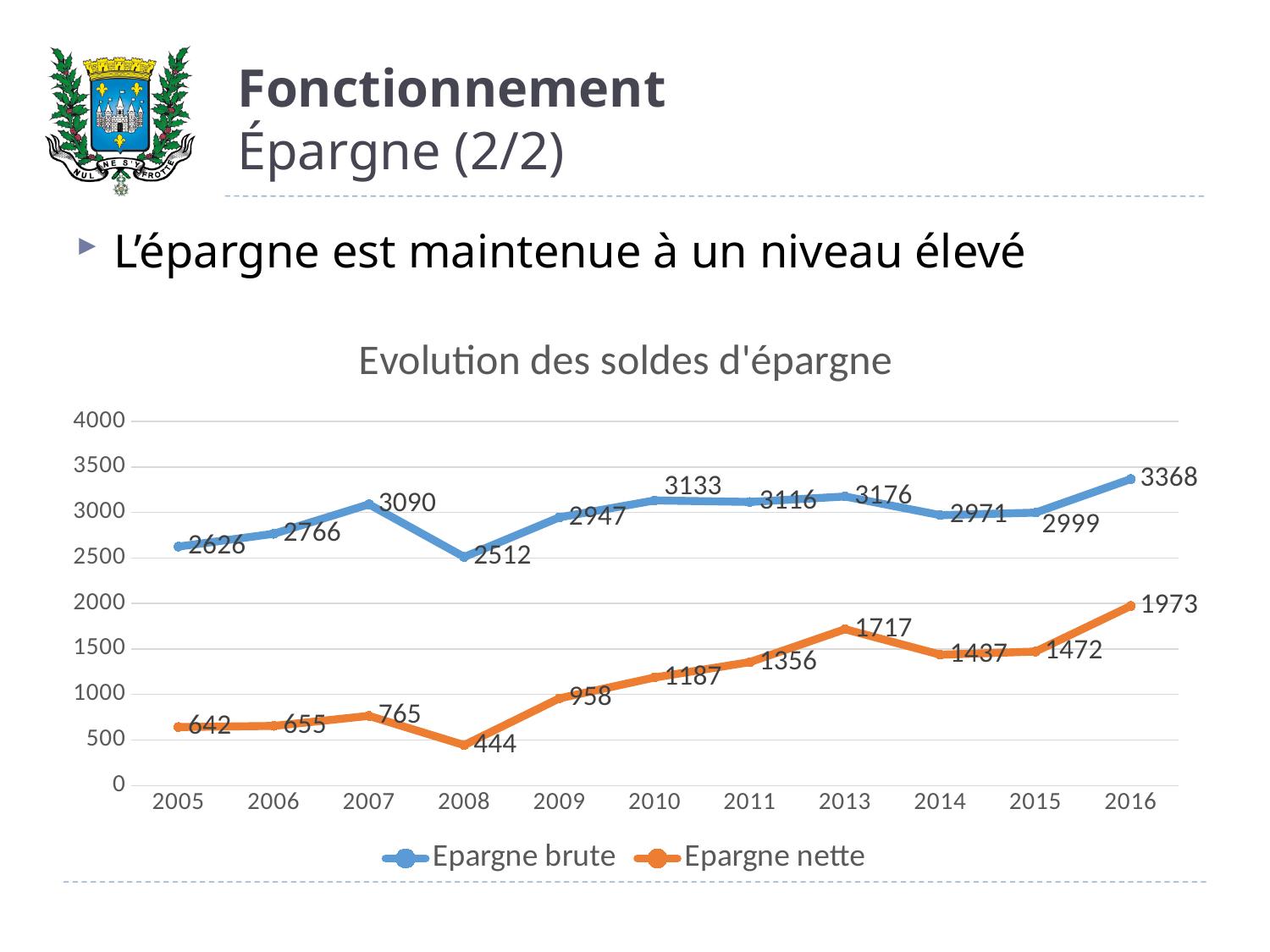
In which year is Epargne nette highest? 2016 In which year is Epargne brute lowest? 2008 What is the value of Epargne nette in 2008? 444 What is the difference between Epargne brute and Epargne nette in 2016? 1395 Which is larger: Epargne nette in 2014 or Epargne nette in 2015? 2015 What kind of chart is shown? line chart What is the title of the chart? Evolution des soldes d'épargne Is the value of Epargne brute in 2007 greater or less than 3000? greater How many years are shown on the x axis? 11 What is the value of Epargne nette in 2013? 1717 How many series does the legend list? 2 What is the value of Epargne brute in 2016? 3368